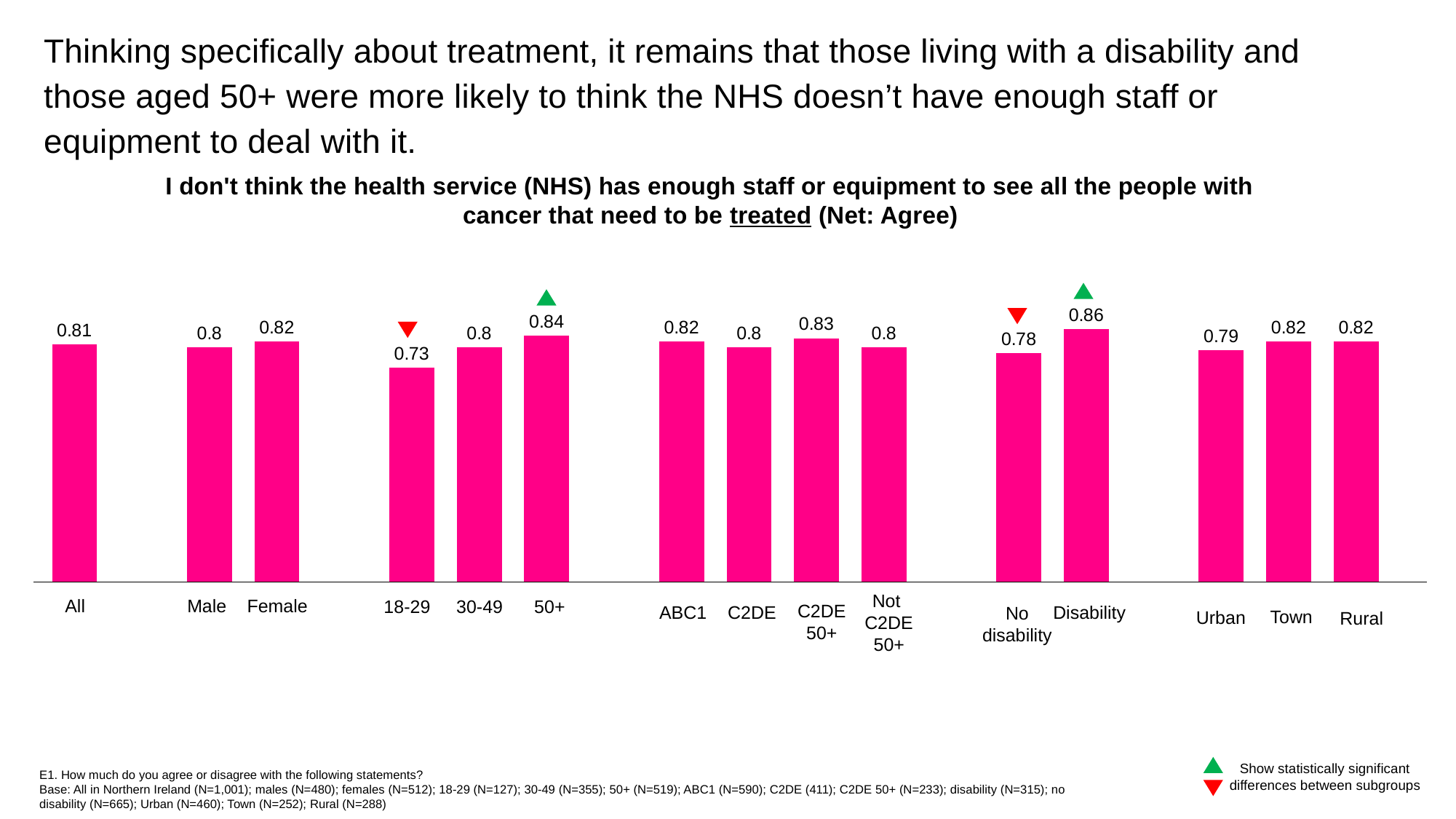
Which category has the highest value? Disability What is the value for the 'All' category? 0.81 How many categories (bars) are shown in the chart? 15 Which is larger, the value for Female or the value for Male? Female What is the value for the 18-29 age group? 0.73 What colour are the bars in the chart? Pink What kind of chart is shown on the slide? Bar chart What is the value for the Disability group? 0.86 What is the difference between the values for 50+ and 18-29? 0.11 What is the value for the Urban category? 0.79 Which category has the lowest value? 18-29 What is the difference between the values for Disability and No disability? 0.08